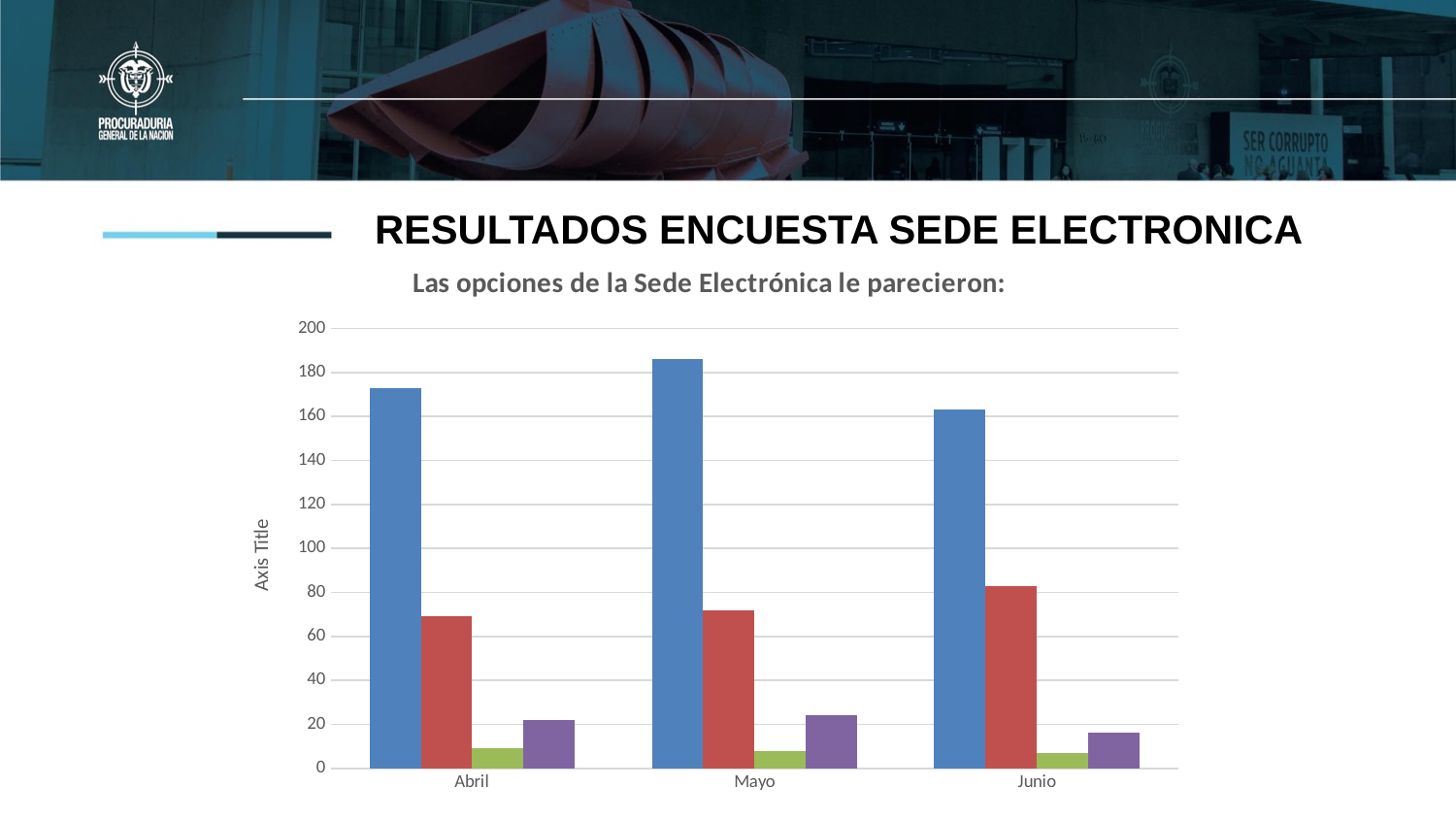
Is the value of the blue bar for Junio greater or less than 180? less Is the value of the blue bar for Mayo greater or less than 180? greater What is the label on the vertical axis of the chart? Axis Title What kind of chart is shown on the slide? bar chart What is the title of the chart? Las opciones de la Sede Electrónica le parecieron: Is the value of the red bar for Abril greater or less than 80? less In which month is the blue bar the shortest? Junio Which is larger, the red bar for Junio or the red bar for Abril? Junio In which month is the blue bar the tallest? Mayo How many months are shown on the x axis of the chart? 3 Do the purple bars rise or fall from Mayo to Junio? fall